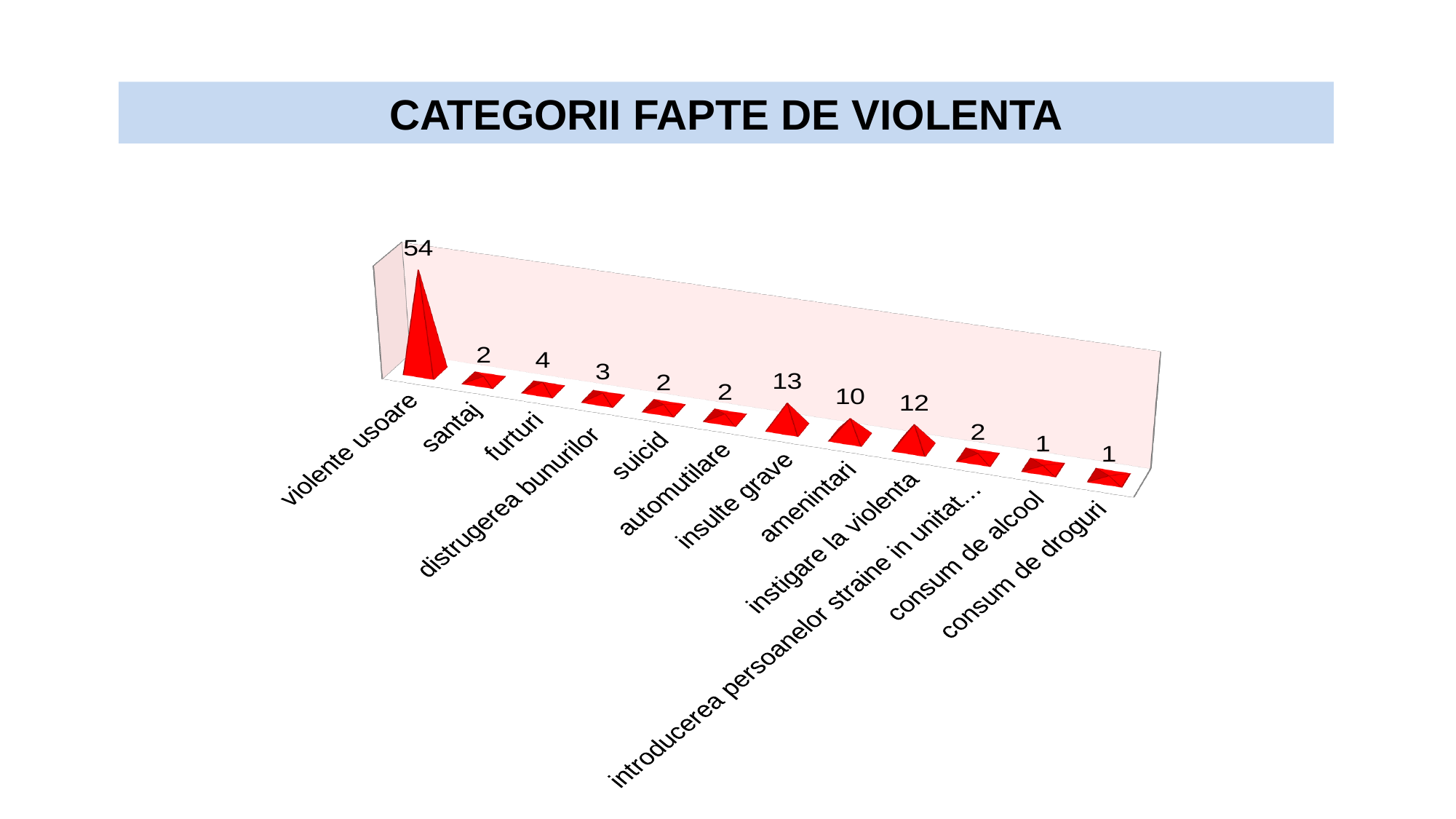
What is the value for furturi? 4 What is the value for instigare la violenta? 12 What is the value for insulte grave? 13 What is the value for violente usoare? 54 What is the title of the chart? CATEGORII FAPTE DE VIOLENTA What kind of chart is shown on the slide? bar chart Which category has the highest value? violente usoare How many categories are shown in the chart? 12 What is the difference between the values for instigare la violenta and amenintari? 2 Which is larger, the value for insulte grave or the value for amenintari? insulte grave What is the value for amenintari? 10 What is the difference between the values for violente usoare and insulte grave? 41